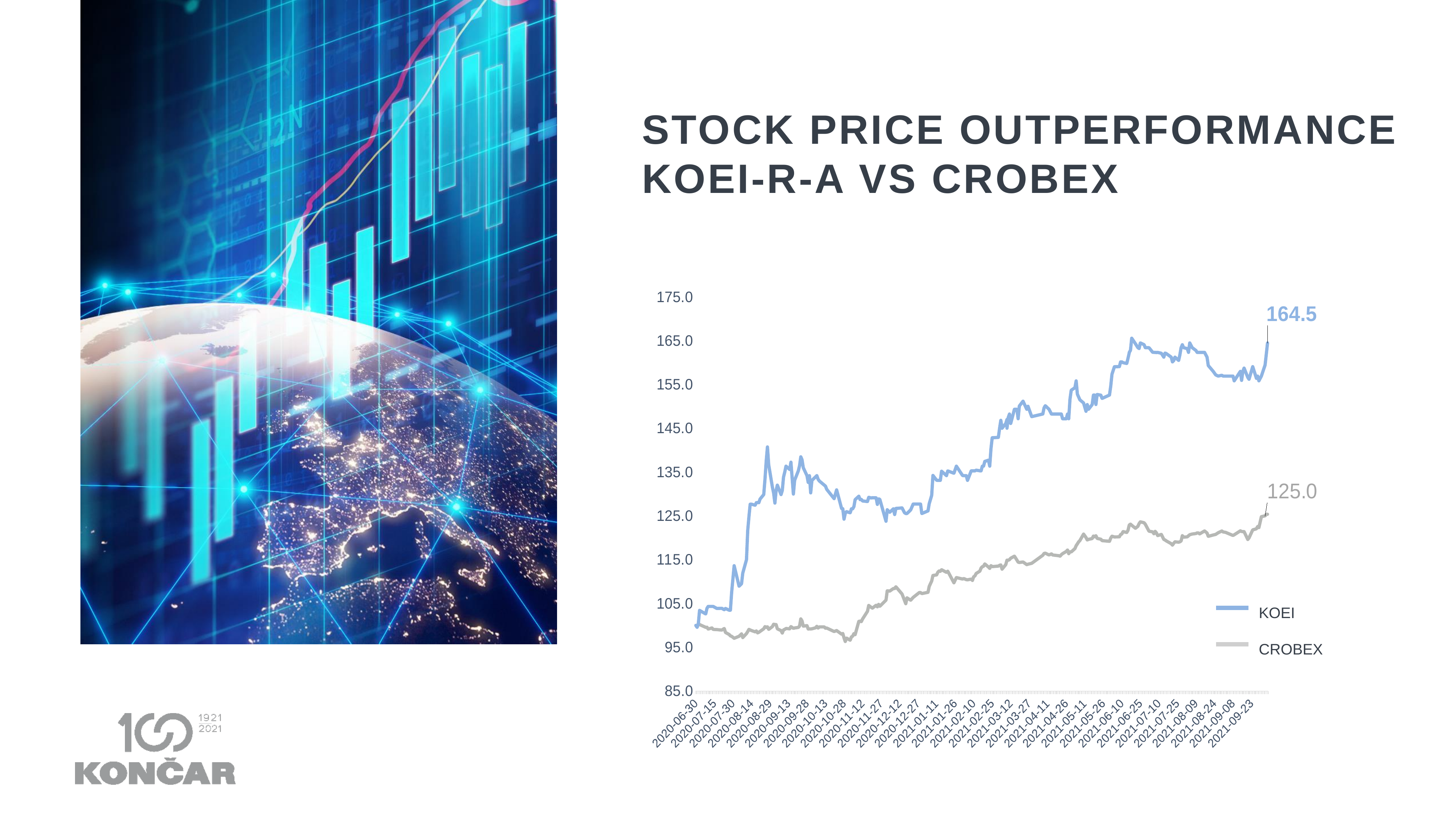
What is the title of the chart on the slide? STOCK PRICE OUTPERFORMANCE KOEI-R-A VS CROBEX Do the CROBEX values generally rise or fall across the period shown? Rise Do the KOEI values generally rise or fall from 2020-06-30 to 2021-09-23? Rise Is the CROBEX value around 2020-10-28 greater or less than 105.0? less How many series does the legend list? 2 Which series is drawn in grey? CROBEX Which series ends at a higher value, KOEI or CROBEX? KOEI Is the KOEI value around 2021-06-25 greater or less than 155.0? greater What kind of chart is shown on the slide? Line chart What is the final labelled value of the CROBEX series? 125.0 What is the final labelled value of the KOEI series? 164.5 What is the difference between the final labelled values of KOEI and CROBEX? 39.5